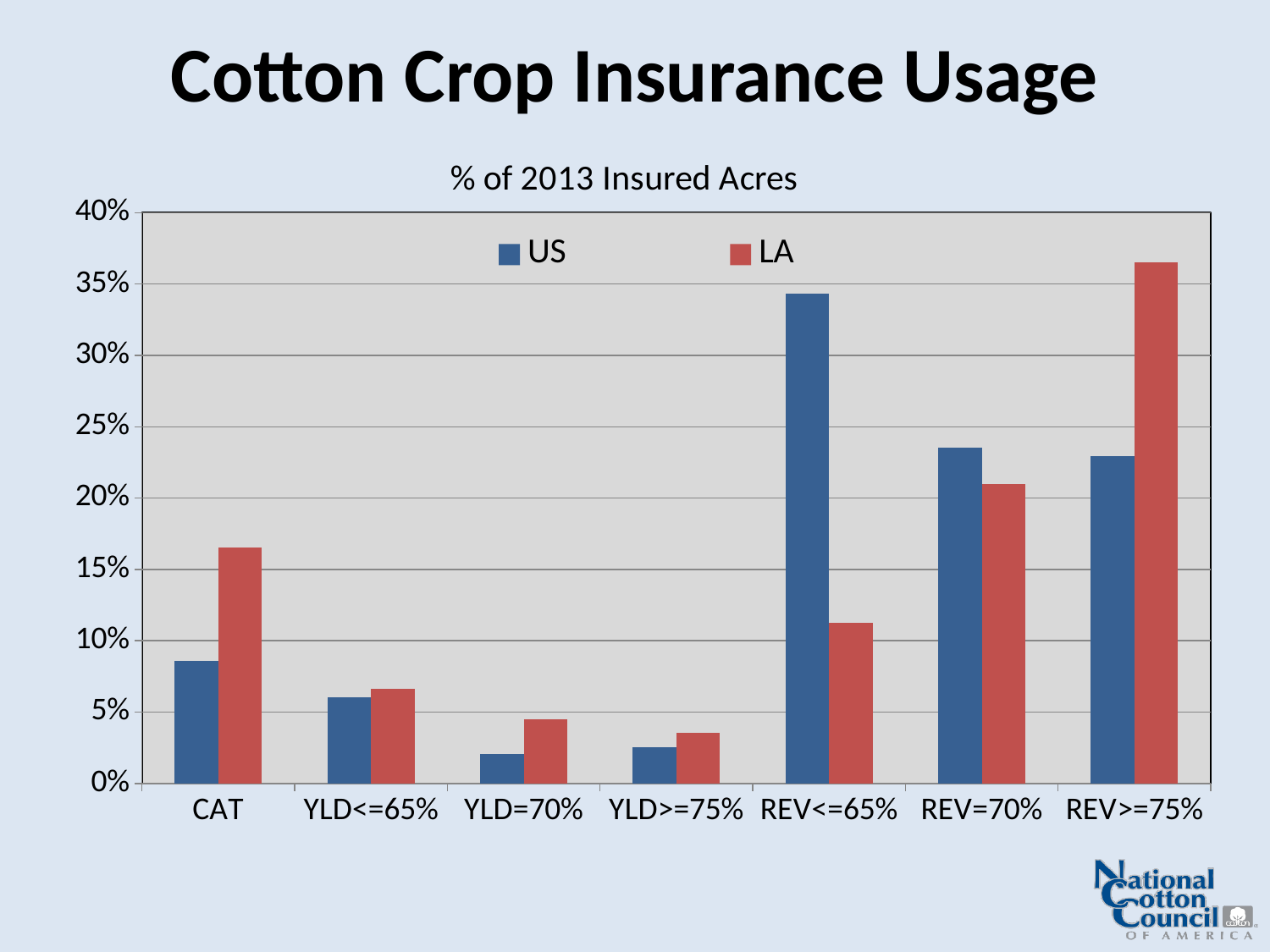
What kind of chart is shown on the slide? bar chart How many series does the legend list? 2 For the REV<=65% category, which series has the larger value, US or LA? US Which category has the highest value for the US series? REV<=65% Which category has the lowest value for the US series? YLD=70% Which category has the highest value for the LA series? REV>=75% For the CAT category, which series has the larger value, US or LA? LA Is the US value for CAT greater or less than 10%? less What is the subtitle shown above the chart? % of 2013 Insured Acres Is the US value for REV<=65% greater or less than 30%? greater How many categories are shown on the x axis? 7 Is the LA value for CAT greater or less than 15%? greater